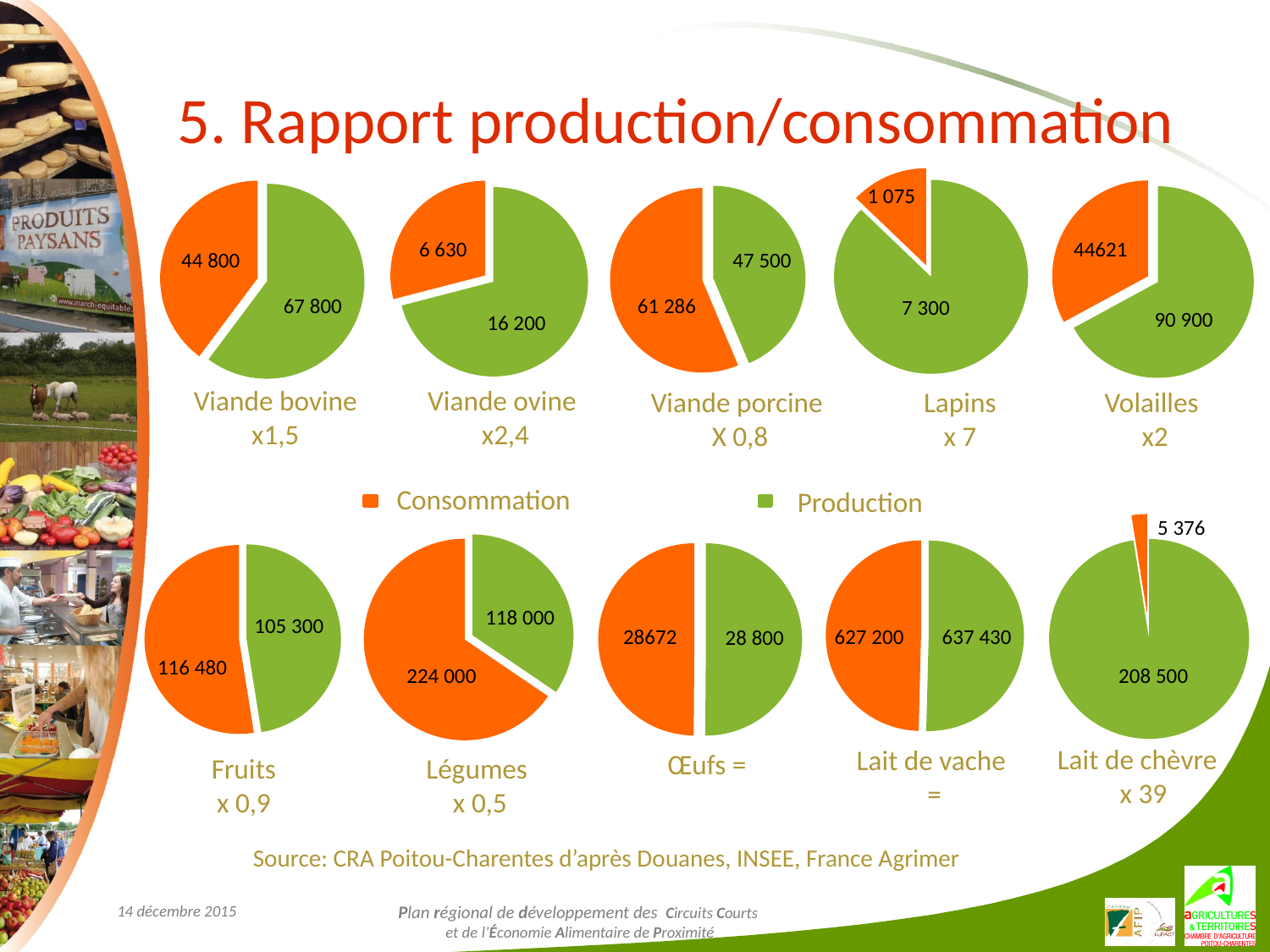
In the Lapins pie chart, what is the value for Production? 7 300 What kind of chart is used for Œufs? Pie chart In the Lait de vache pie chart, what is the total of Consommation and Production? 1 264 630 In the Fruits pie chart, what is the difference between Consommation and Production? 11 180 In the Lait de chèvre pie chart, what is the value for Consommation? 5 376 In the Viande bovine pie chart, what is the value for Production? 67 800 In the Viande ovine pie chart, what is the value for Consommation? 6 630 In the Légumes pie chart, what is the difference between Consommation and Production? 106 000 How many series does the legend list? 2 In the Viande porcine pie chart, which slice is larger, Consommation or Production? Consommation In the Volailles pie chart, which slice is larger, Consommation or Production? Production How many pie charts are shown on the slide? 10